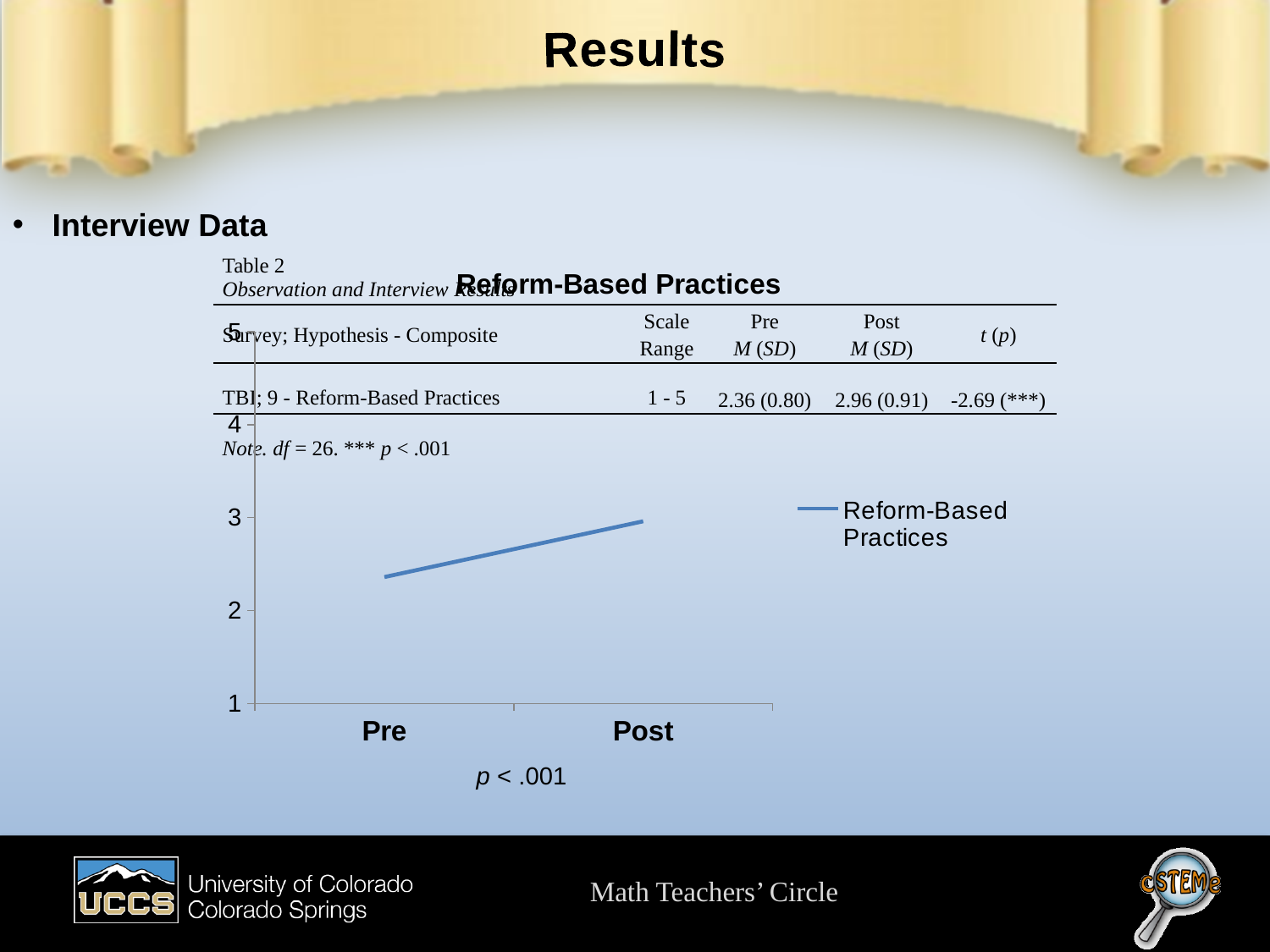
What significance note is printed below the x axis of the chart? p < .001 Is the Pre value in the Reform-Based Practices chart greater or less than 3? less How many series does the legend of the Reform-Based Practices chart list? 1 What kind of chart is shown on the slide? line chart Which is larger in the Reform-Based Practices chart, the Pre value or the Post value? Post Is the Post value in the Reform-Based Practices chart greater or less than 4? less Which category has the lowest value in the Reform-Based Practices chart? Pre How many categories are shown on the x axis of the Reform-Based Practices chart? 2 Which category has the highest value in the Reform-Based Practices chart? Post What is the title of the chart on the slide? Reform-Based Practices Does the Reform-Based Practices line rise or fall from Pre to Post? rise Is the Pre value in the Reform-Based Practices chart greater or less than 2? greater